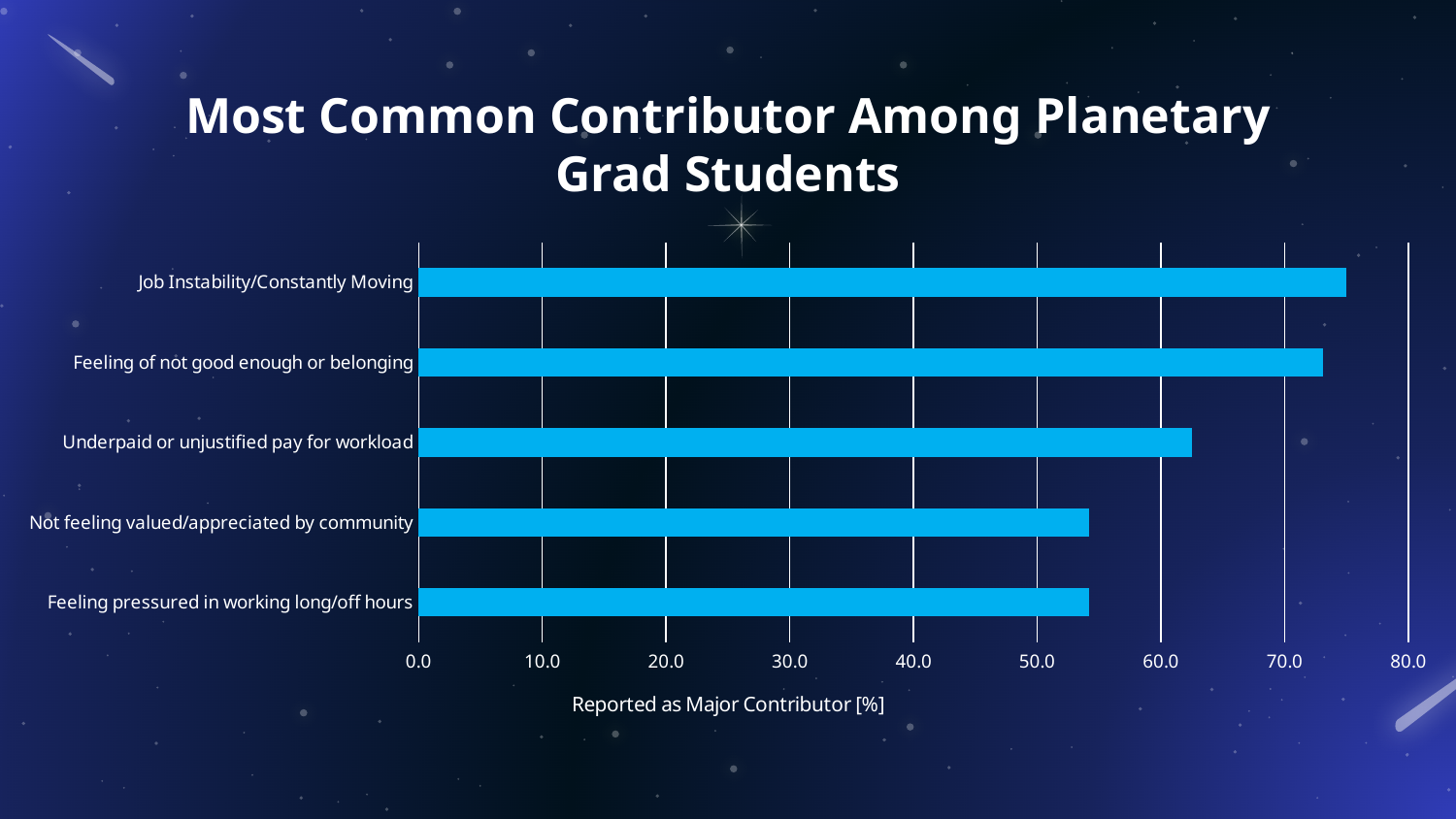
What is the label of the horizontal axis? Reported as Major Contributor [%] What is the title of the chart? Most Common Contributor Among Planetary Grad Students How many categories are plotted in the chart? 5 Which is larger: the value for Job Instability/Constantly Moving or the value for Underpaid or unjustified pay for workload? Job Instability/Constantly Moving Is the value for Not feeling valued/appreciated by community greater or less than 50.0? greater Which category has the highest reported percentage? Job Instability/Constantly Moving Is the value for Underpaid or unjustified pay for workload greater or less than 70.0? less Is the value for Job Instability/Constantly Moving greater or less than 70.0? greater Which is larger: the value for Underpaid or unjustified pay for workload or the value for Not feeling valued/appreciated by community? Underpaid or unjustified pay for workload What kind of chart is shown on the slide? bar chart